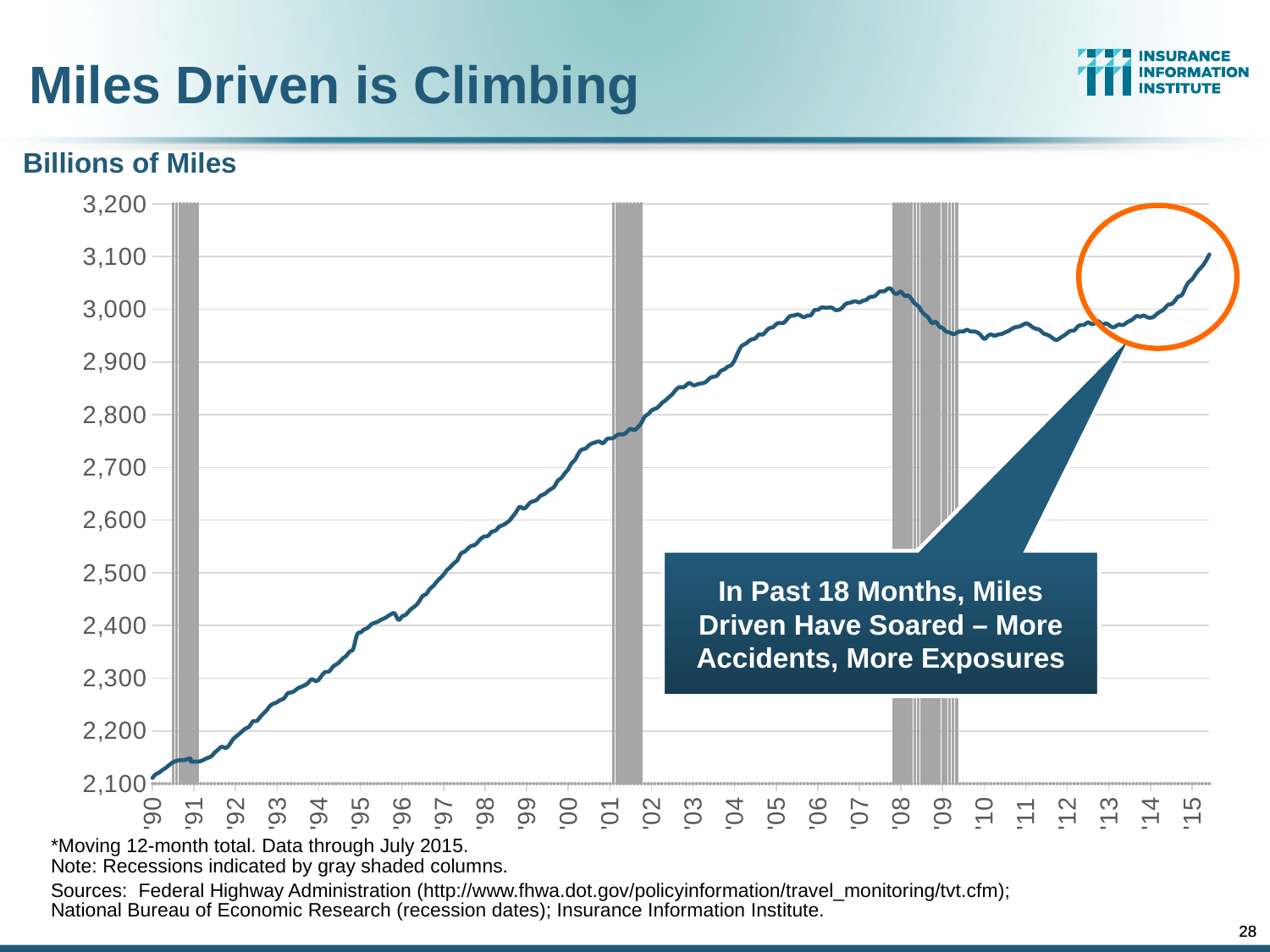
Is the value for '99 greater or less than 2,700? less Which year label on the x axis has the highest value of miles driven? '15 Do the values of miles driven generally rise or fall from '90 to '15? rise Is the value for '95 greater or less than 2,500? less Is the value for '15 greater or less than 3,000? greater Which year label on the x axis has the lowest value of miles driven? '90 What kind of chart is shown on the slide? line chart What is the highest tick value shown on the y axis? 3,200 How many year labels are shown on the x axis? 26 According to the note, what do the gray shaded columns indicate? Recessions